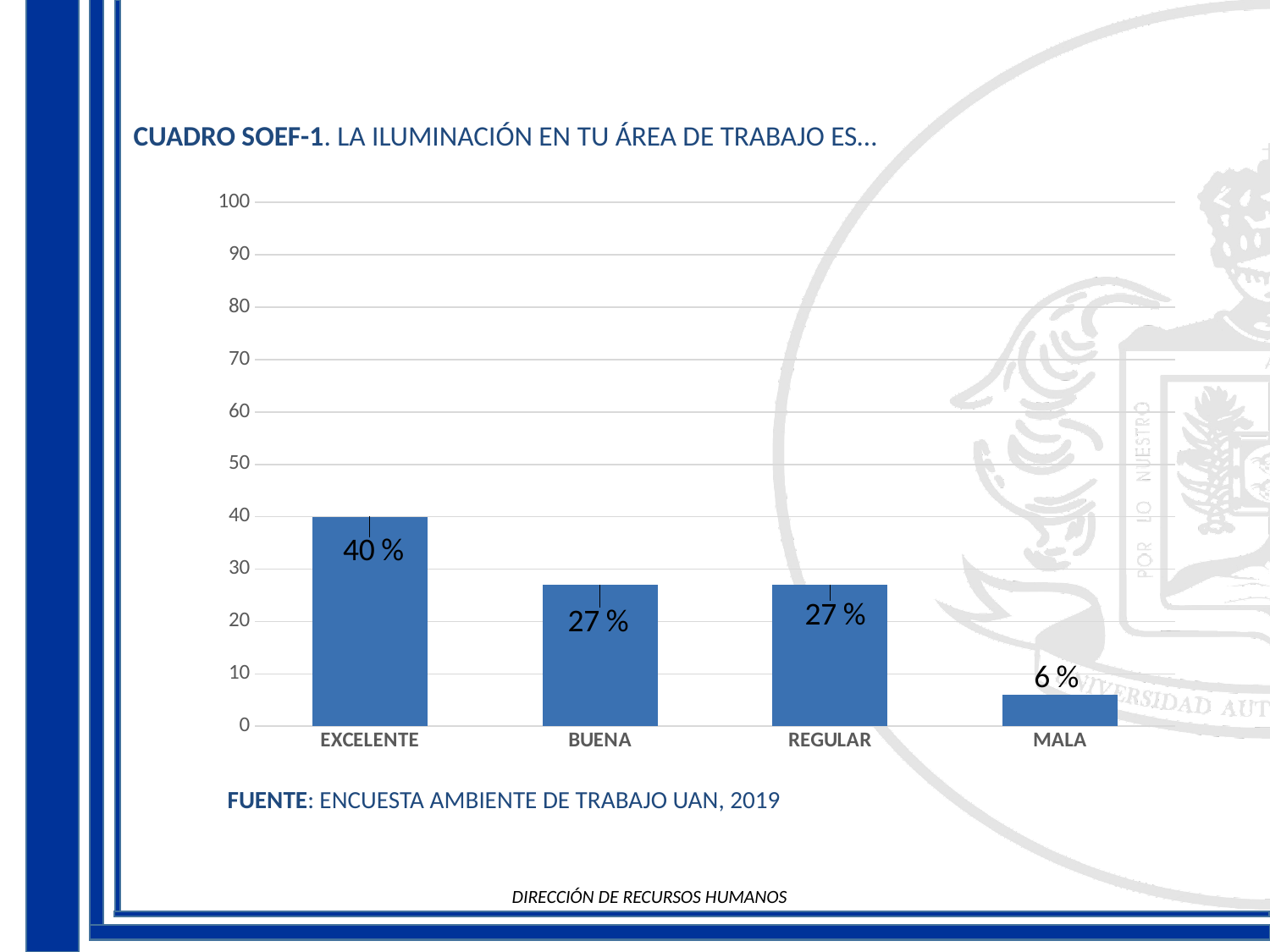
What is the value for REGULAR? 27 % What is the difference between the values for REGULAR and MALA? 21 % Is the value for BUENA greater or less than 30? less What is the source cited below the chart? ENCUESTA AMBIENTE DE TRABAJO UAN, 2019 What is the difference between the values for EXCELENTE and BUENA? 13 % How many categories are shown on the x axis? 4 What is the value for EXCELENTE? 40 % Which is larger, the value for EXCELENTE or the value for MALA? EXCELENTE Which category has the highest value? EXCELENTE What is the value for MALA? 6 % What kind of chart is shown on the slide? bar chart Which category has the lowest value? MALA